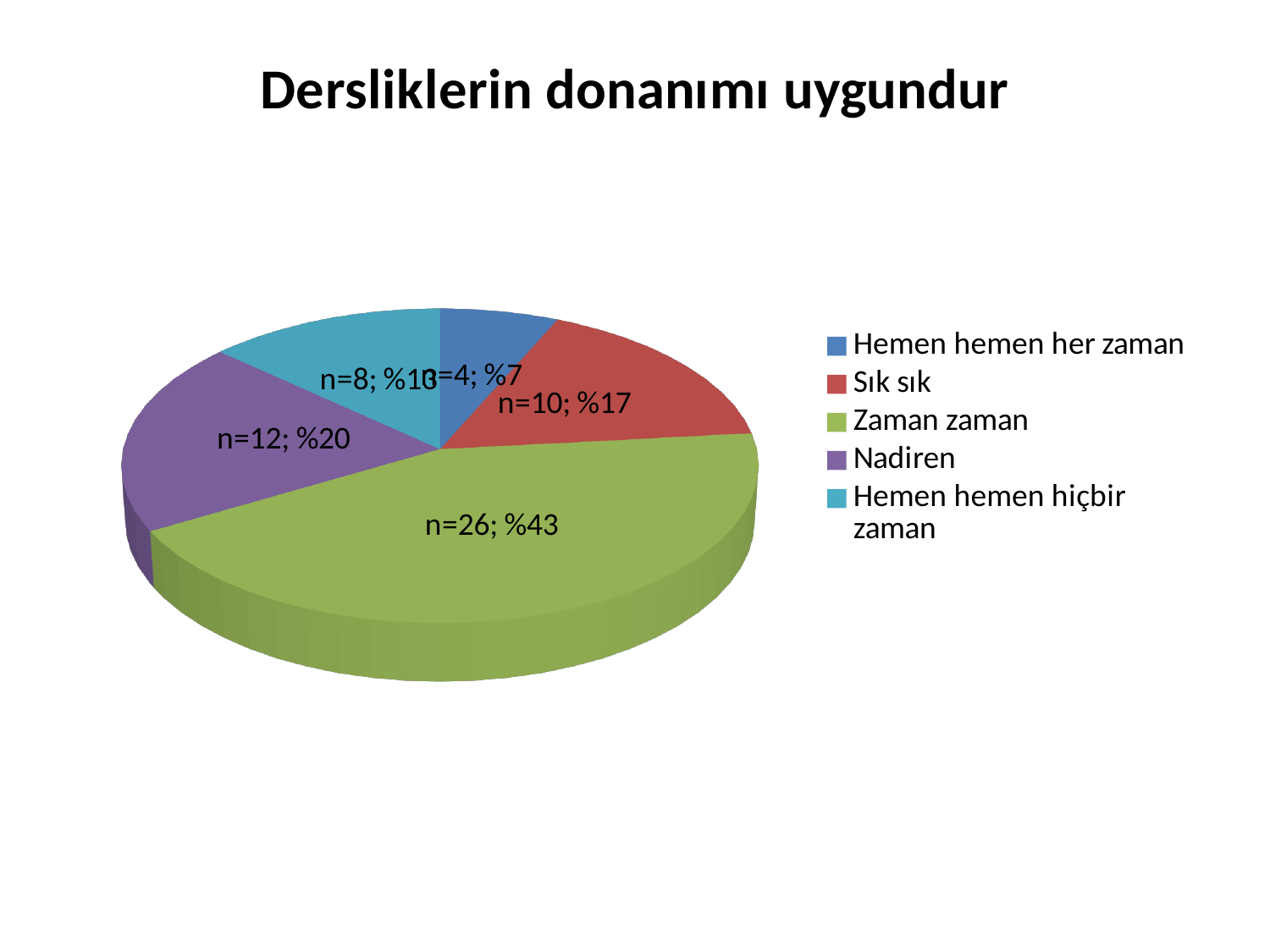
What is the value shown for the Hemen hemen her zaman slice? n=4; %7 Which category has the largest slice? Zaman zaman What kind of chart is shown on the slide? pie chart What is the value shown for the Nadiren slice? n=12; %20 What is the title of the chart? Dersliklerin donanımı uygundur How many categories does the legend list? 5 Which slice is larger, Sık sık or Nadiren? Nadiren What is the n value for the Hemen hemen hiçbir zaman slice? n=8 What is the value shown for the Zaman zaman slice? n=26; %43 What is the value shown for the Sık sık slice? n=10; %17 What is the difference in n between the Zaman zaman and Nadiren slices? 14 Which category has the smallest slice? Hemen hemen her zaman